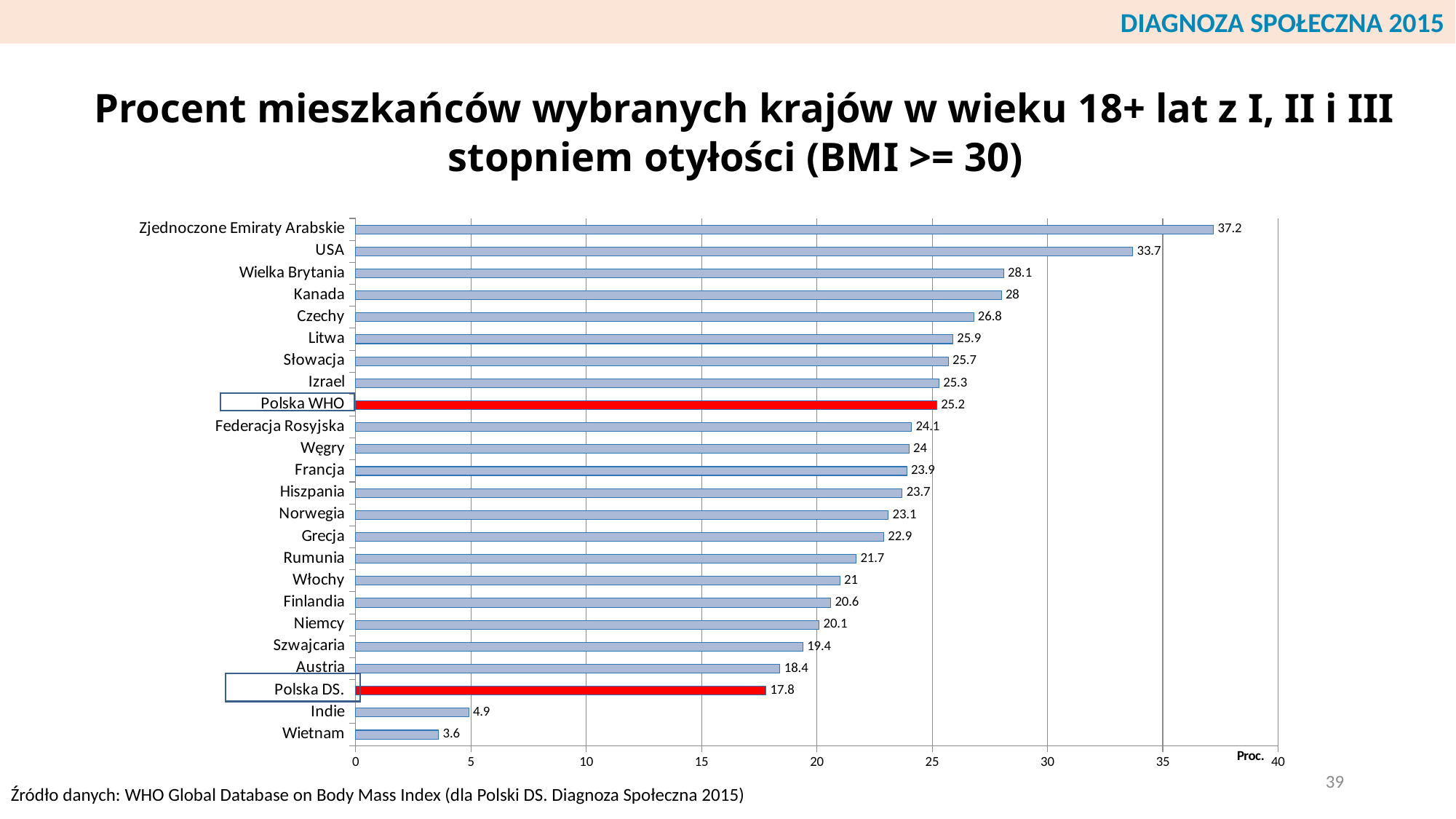
Which country has the highest value? Zjednoczone Emiraty Arabskie What is the value for Niemcy? 20.1 Which country has the lowest value? Wietnam Which is larger, the value for Kanada or the value for Czechy? Kanada What is the difference between the values for Polska WHO and Polska DS.? 7.4 What kind of chart is shown on the slide? bar chart What is the value for Polska DS.? 17.8 Is the value for Austria greater or less than 20? less What is the value for USA? 33.7 How many countries are shown in the chart? 24 Which two bars are coloured red? Polska WHO and Polska DS. What is the value for Polska WHO? 25.2